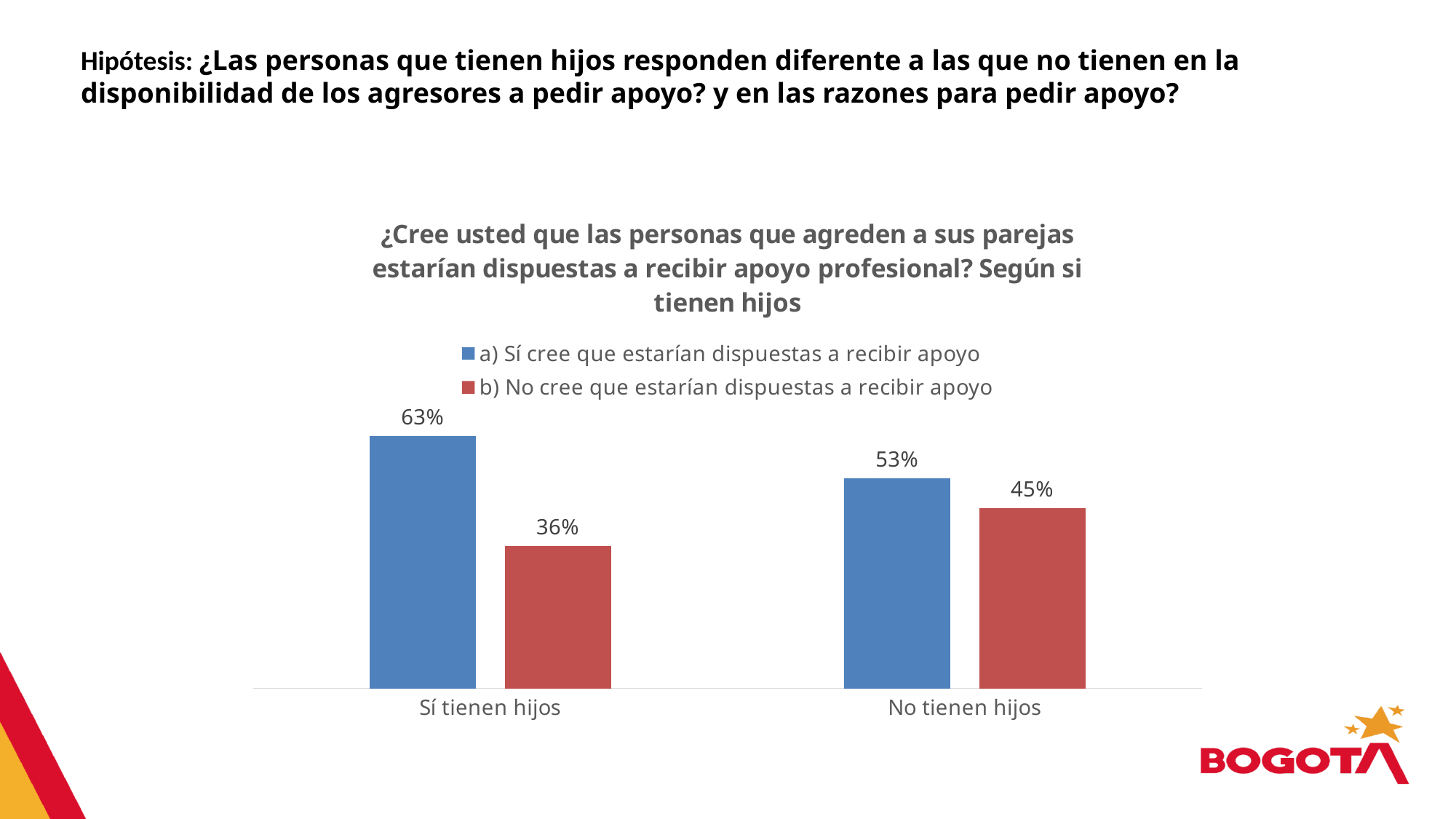
Which category has the lowest value for 'b) No cree que estarían dispuestas a recibir apoyo'? Sí tienen hijos What is the value for 'b) No cree que estarían dispuestas a recibir apoyo' in the 'No tienen hijos' category? 45% What is the value for 'a) Sí cree que estarían dispuestas a recibir apoyo' in the 'Sí tienen hijos' category? 63% What kind of chart is shown on the slide? Bar chart What is the value for 'b) No cree que estarían dispuestas a recibir apoyo' in the 'Sí tienen hijos' category? 36% What is the difference between the 'a) Sí cree' and 'b) No cree' values in the 'Sí tienen hijos' category? 27% How many categories are shown on the x axis? 2 Which is larger: the 'b) No cree' value for 'Sí tienen hijos' or for 'No tienen hijos'? No tienen hijos How many series does the legend list? 2 What is the value for 'a) Sí cree que estarían dispuestas a recibir apoyo' in the 'No tienen hijos' category? 53% Which category has the highest value for 'a) Sí cree que estarían dispuestas a recibir apoyo'? Sí tienen hijos What is the difference between the 'a) Sí cree' values for 'Sí tienen hijos' and 'No tienen hijos'? 10%